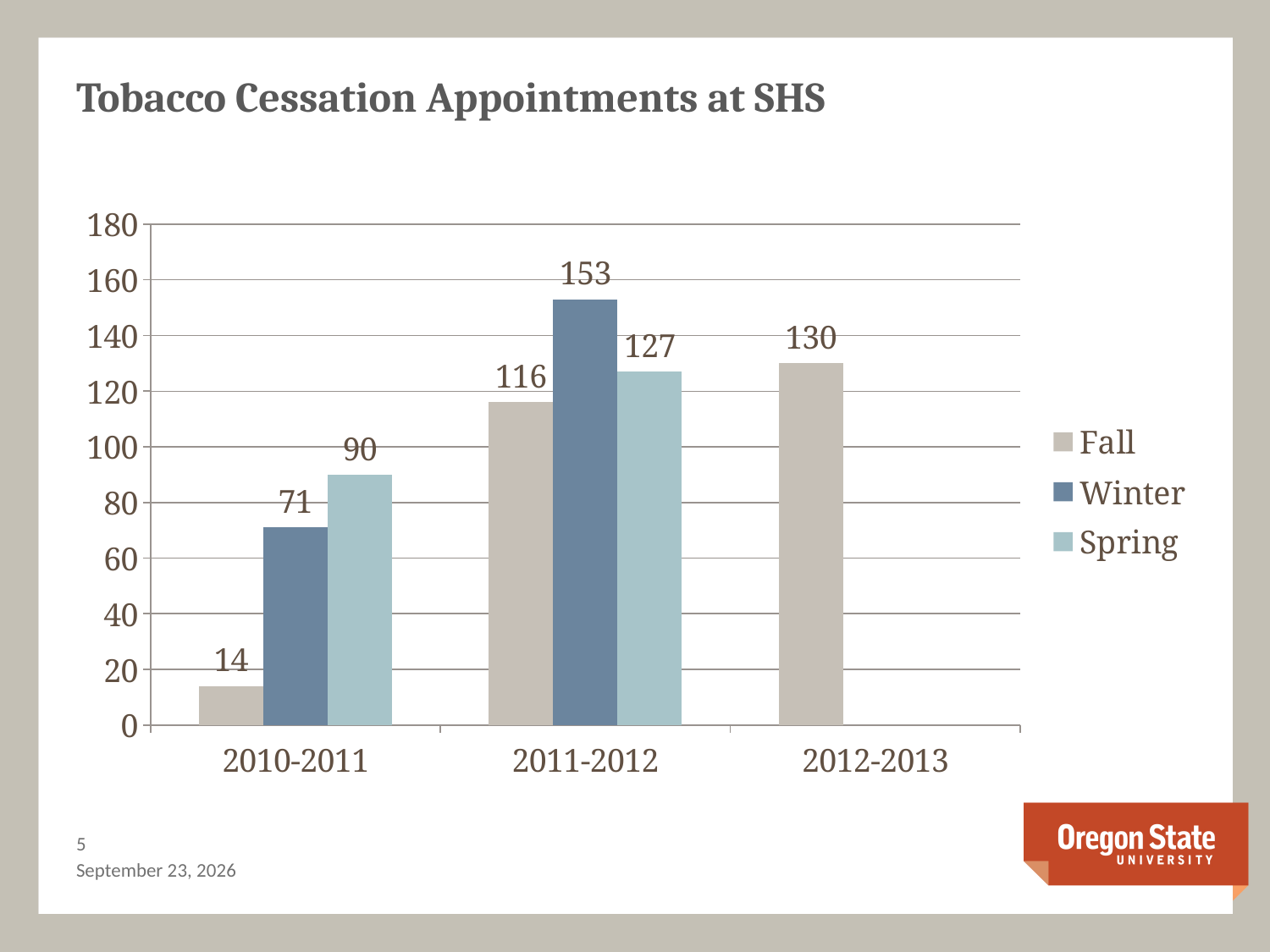
Which is larger, the Spring value for 2010-2011 or the Winter value for 2010-2011? Spring Which season has the highest value in 2010-2011? Spring What is the difference between the Winter and Fall values for 2011-2012? 37 How many series does the legend list? 3 What is the Winter value for 2011-2012? 153 Do the Fall values rise or fall from 2010-2011 to 2012-2013? Rise What is the Spring value for 2011-2012? 127 What is the Fall value for 2010-2011? 14 Which season has the lowest value in 2011-2012? Fall What kind of chart is shown on the slide? Bar chart How many academic year categories are shown on the x axis? 3 What is the Fall value for 2012-2013? 130